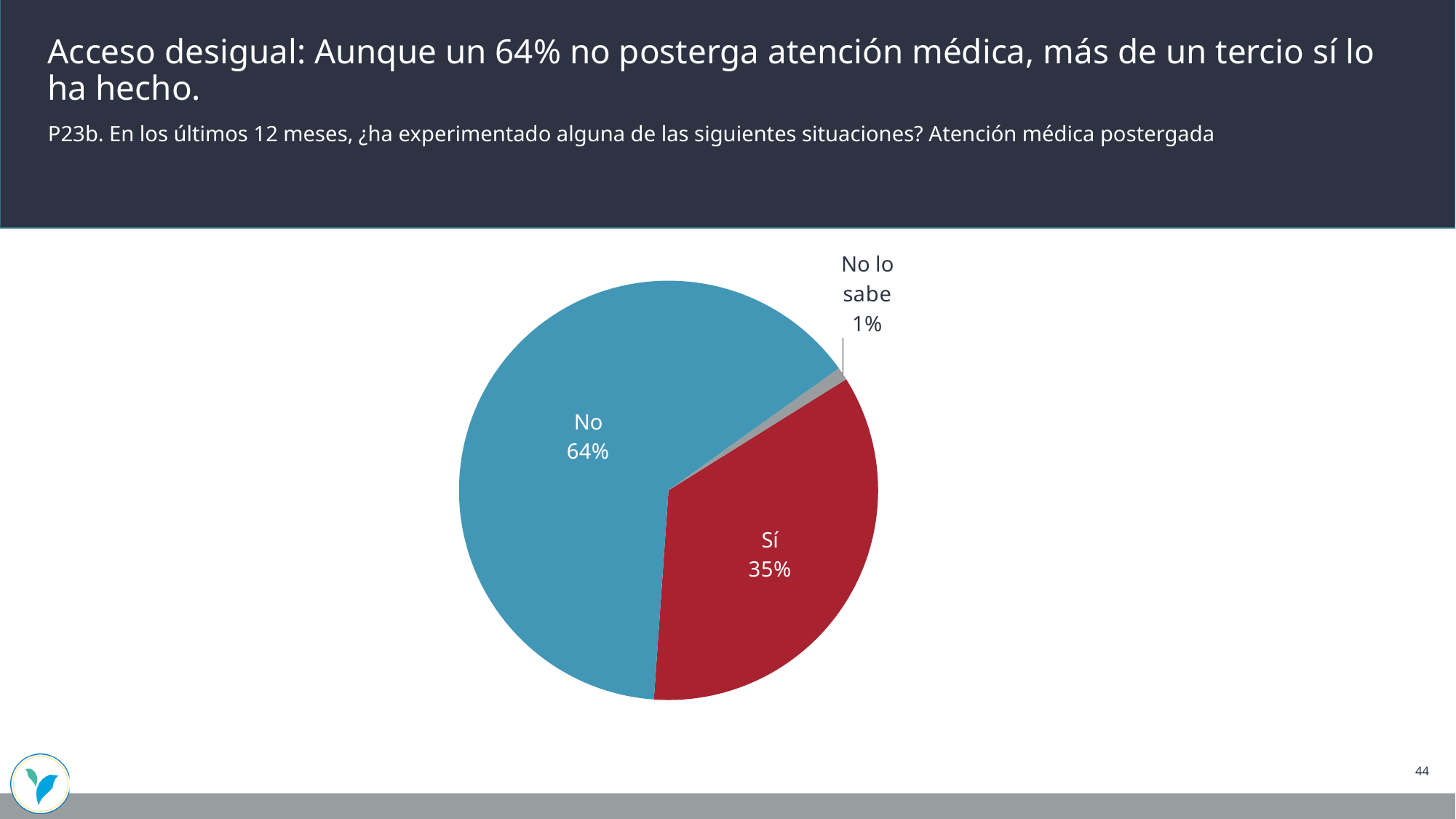
What is the difference in percentage points between "No" and "Sí"? 29 What percentage of respondents answered "Sí"? 35% Which is larger, the share for "Sí" or the share for "No lo sabe"? Sí Which category has the smallest share of the pie? No lo sabe What kind of chart is shown on the slide? Pie chart What colour is the "No" slice of the pie? Blue Which category has the largest share of the pie? No What percentage of respondents answered "No lo sabe"? 1% What colour is the "Sí" slice of the pie? Red How many slices does the pie chart have? 3 What percentage of respondents answered "No"? 64% What share of the pie does the "Sí" slice represent? 35%